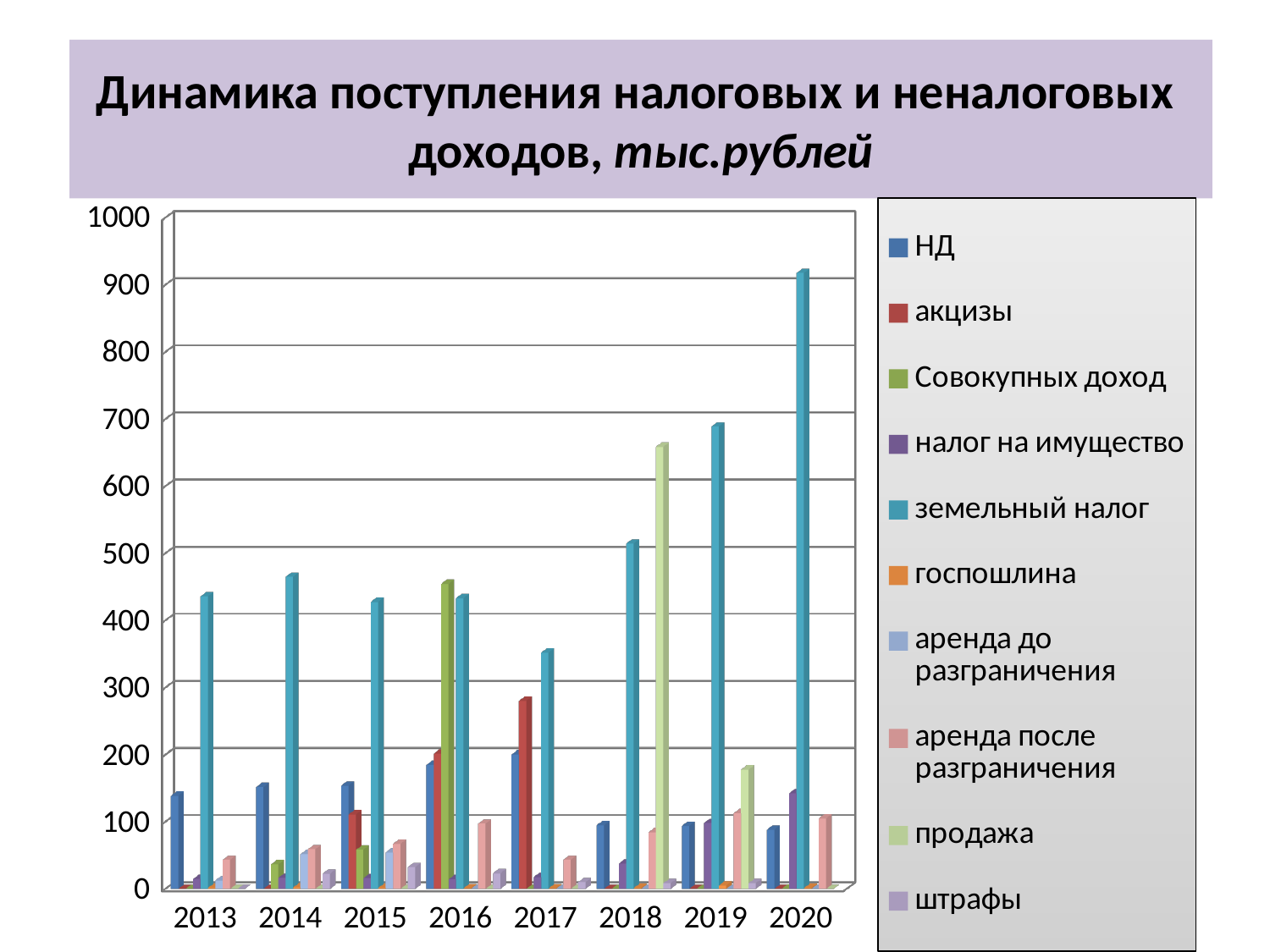
In which year is the value for земельный налог the highest? 2020 In which year is the value for продажа the highest? 2018 How many series does the legend list? 10 In which year is the value for акцизы the highest? 2017 Which is larger: the value for земельный налог in 2014 or in 2015? 2014 What kind of chart is shown on the slide? Bar chart Is the value for продажа in 2018 greater or less than 600? greater How many years are shown on the x axis of the chart? 8 In which year is the value for земельный налог the lowest? 2017 Does the value for земельный налог rise or fall from 2017 to 2020? rise Is the value for земельный налог in 2017 greater or less than 400? less Is the value for земельный налог in 2020 greater or less than 800? greater